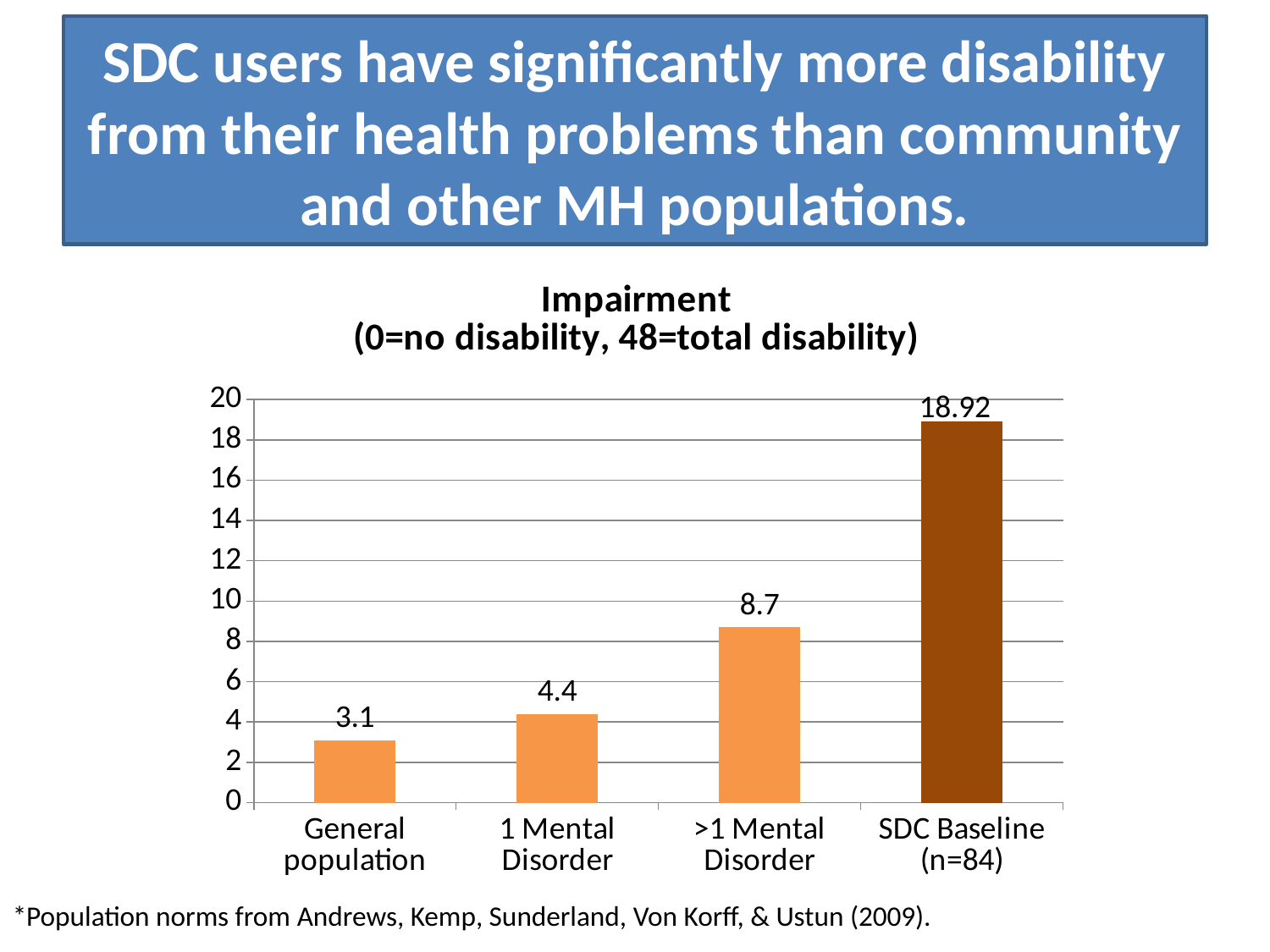
What is the difference between the impairment values for SDC Baseline (n=84) and >1 Mental Disorder? 10.22 What is the impairment value for SDC Baseline (n=84)? 18.92 What is the impairment value for >1 Mental Disorder? 8.7 Which has a larger impairment value, 1 Mental Disorder or >1 Mental Disorder? >1 Mental Disorder Which category has the lowest impairment value? General population Which category has the highest impairment value? SDC Baseline (n=84) What is the impairment value for the General population? 3.1 What is the title of the chart? Impairment (0=no disability, 48=total disability) What is the difference between the impairment values for 1 Mental Disorder and General population? 1.3 What kind of chart is shown on the slide? Bar chart How many categories are shown on the x axis? 4 Do the impairment values rise or fall from left to right along the x axis? Rise